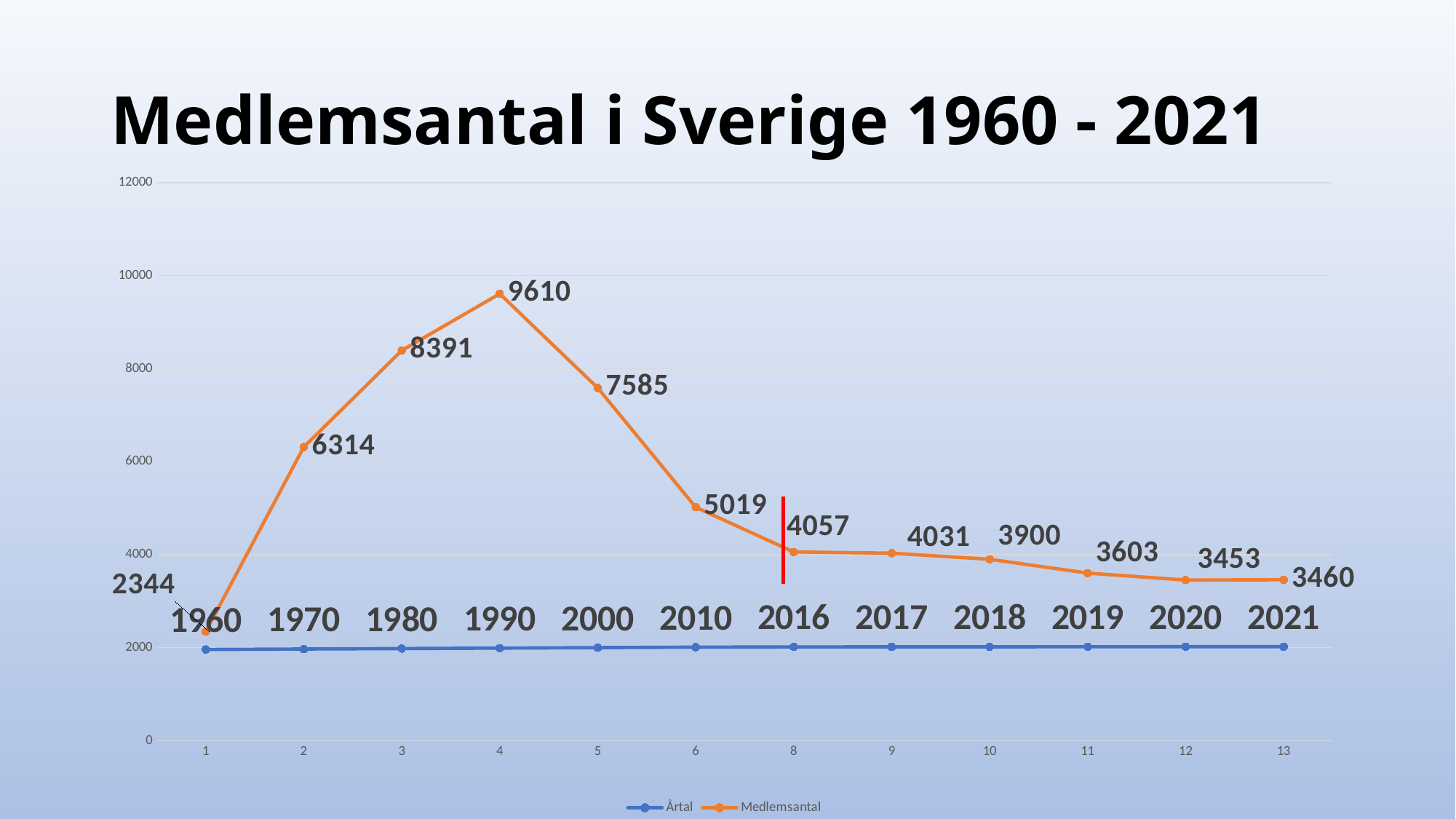
Is the Medlemsantal value for 2010 greater or less than 6000? less How many series does the legend list? 2 Which year has a larger Medlemsantal, 1980 or 2000? 1980 What is the Medlemsantal value for 1960? 2344 In which year is the Medlemsantal highest? 1990 In which year is the Medlemsantal lowest? 1960 How many data points does the Medlemsantal line have? 12 What is the difference between the Medlemsantal in 2016 and in 2021? 597 What is the difference between the Medlemsantal in 1990 and in 2000? 2025 What is the Medlemsantal value for 1990? 9610 What kind of chart is shown on the slide? line chart What is the Medlemsantal value for 2021? 3460